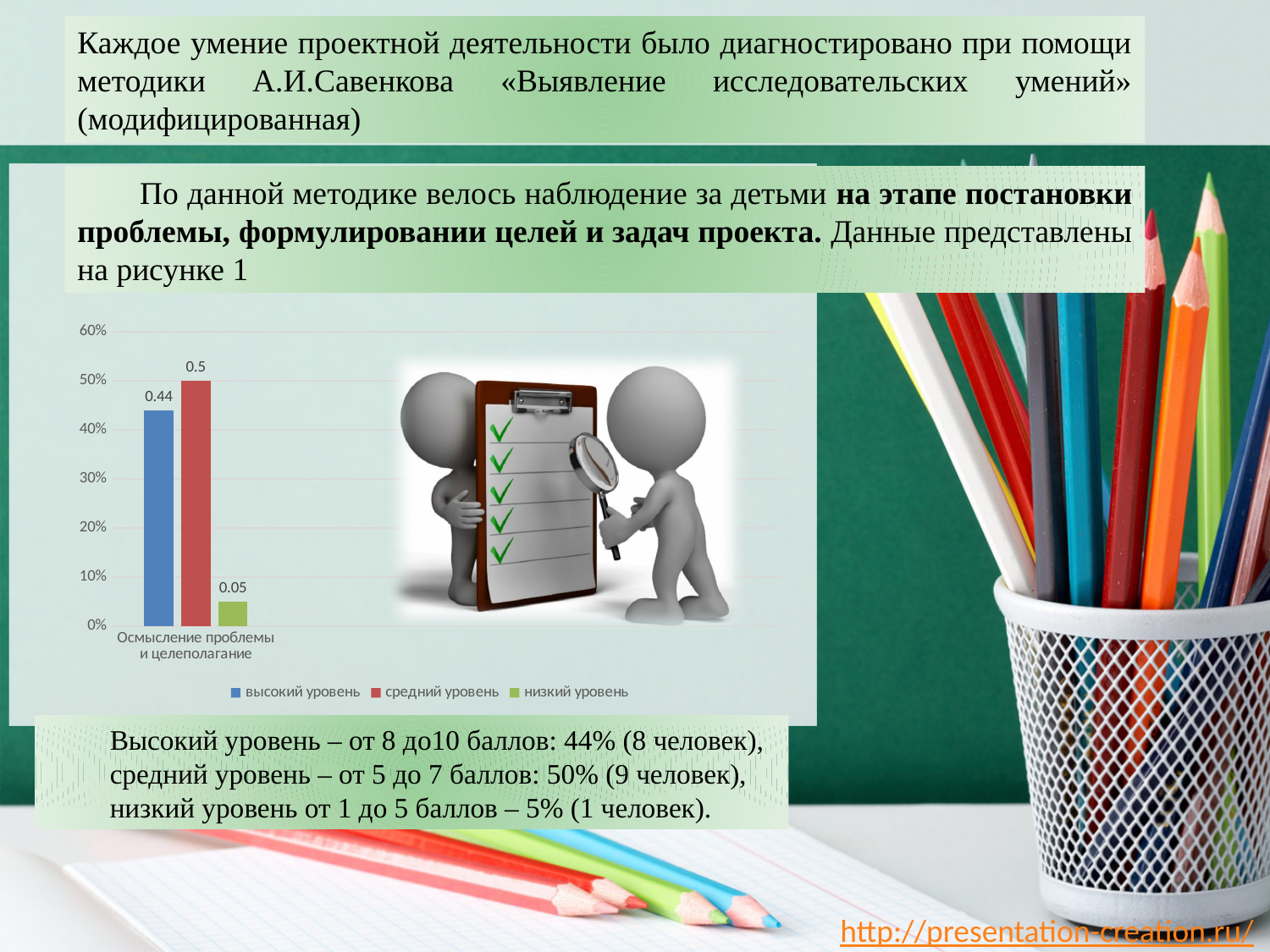
What is the data label for the series 'средний уровень' in the category 'Осмысление проблемы и целеполагание'? 0.5 What is the data label for the series 'высокий уровень' in the category 'Осмысление проблемы и целеполагание'? 0.44 What type of chart is shown on the slide? bar chart Is the value for 'высокий уровень' greater or less than 40%? greater How many series does the legend list? 3 Which is larger: the value for 'высокий уровень' or the value for 'низкий уровень'? высокий уровень Which series has the lowest value in the chart? низкий уровень What is the difference between the values for 'высокий уровень' and 'низкий уровень'? 0.39 How many categories are shown on the x axis of the chart? 1 Which series has the highest value in the chart? средний уровень What is the data label for the series 'низкий уровень' in the category 'Осмысление проблемы и целеполагание'? 0.05 What is the difference between the values for 'средний уровень' and 'высокий уровень'? 0.06